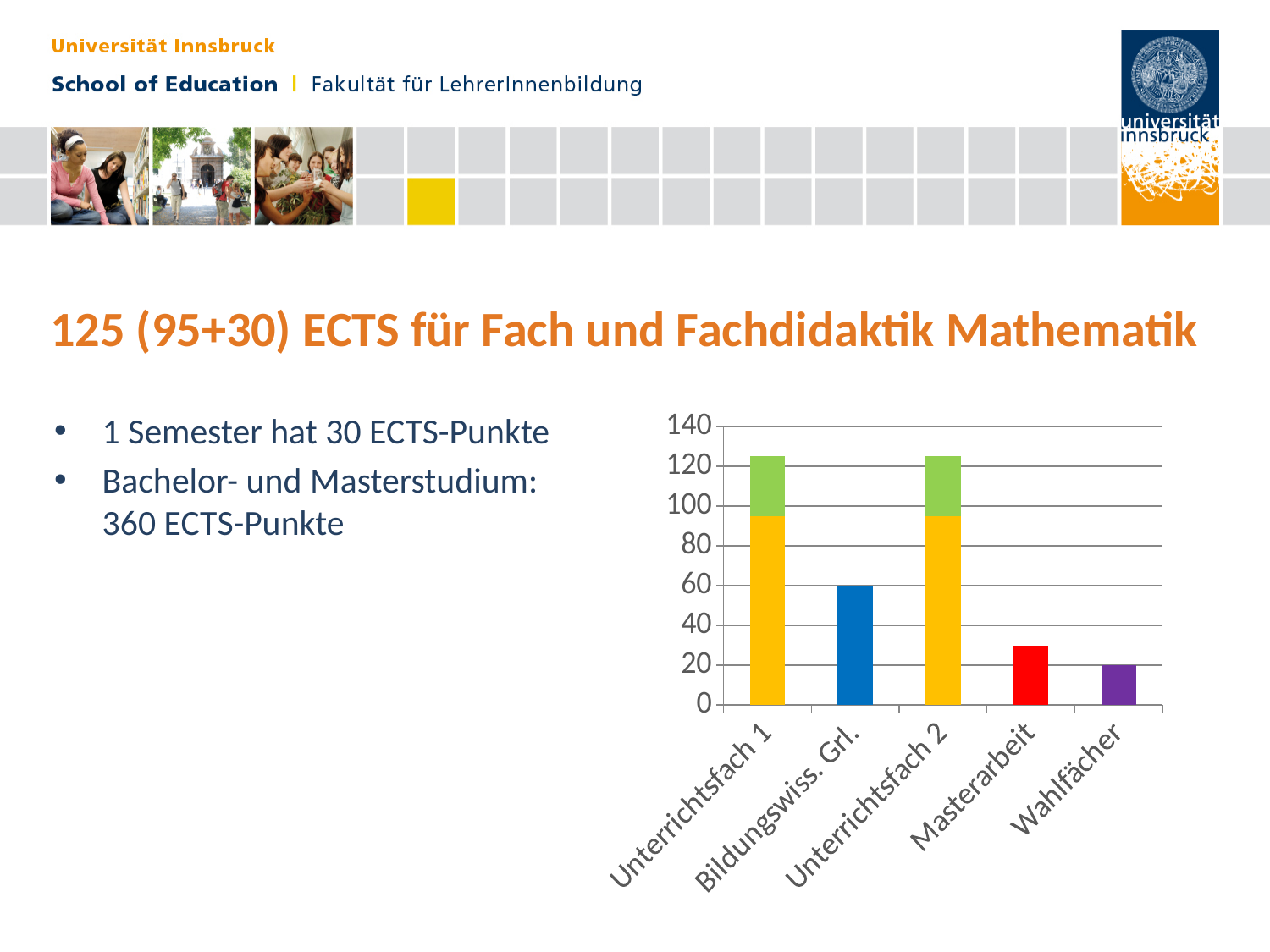
What type of chart is shown on the slide? bar chart How many coloured segments make up the bar for Unterrichtsfach 1? 2 What is the value for Bildungswiss. Grl. in the chart? 60 Is the total value for Unterrichtsfach 2 greater or less than 120? greater What is the value for Wahlfächer in the chart? 20 What is the difference between the values for Bildungswiss. Grl. and Wahlfächer? 40 Is the total value for Unterrichtsfach 1 greater or less than 100? greater Is the value for Masterarbeit greater or less than 40? less Which category has the lowest bar in the chart? Wahlfächer What colour is the bar for Bildungswiss. Grl.? blue How many categories are shown on the x axis of the chart? 5 Which is larger, the value for Bildungswiss. Grl. or the value for Masterarbeit? Bildungswiss. Grl.